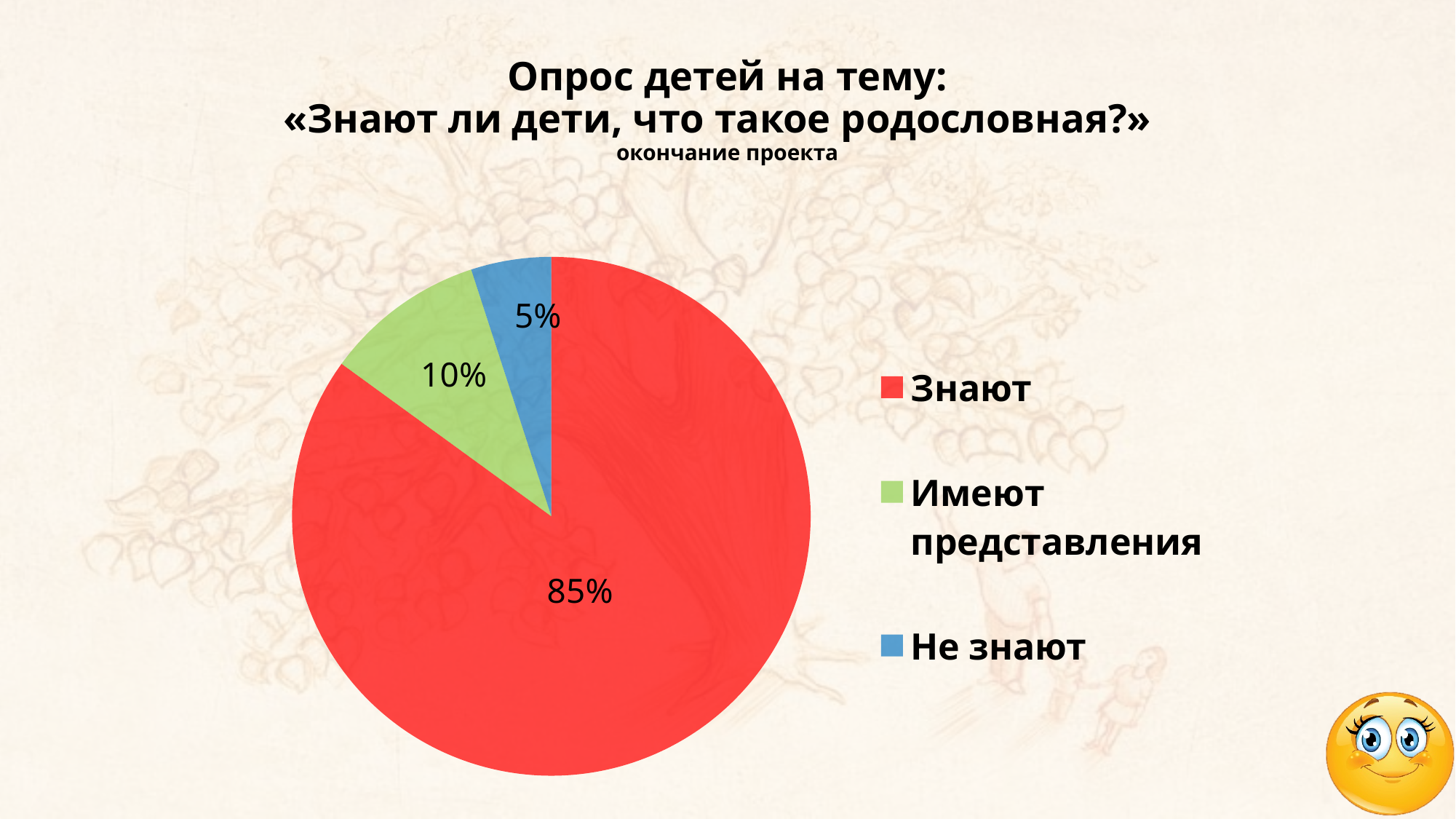
What share of children answered "Знают"? 85% What is the difference between the shares for "Знают" and "Имеют представления"? 75% What share of children answered "Имеют представления"? 10% What colour is the slice for "Не знают"? blue What share of children answered "Не знают"? 5% Which category has the largest slice of the pie? Знают What colour is the slice for "Знают"? red Which category has the smallest slice of the pie? Не знают What kind of chart is shown on the slide? pie chart Which is larger: the share for "Имеют представления" or the share for "Не знают"? Имеют представления How many categories does the pie chart have? 3 What is the difference between the shares for "Имеют представления" and "Не знают"? 5%